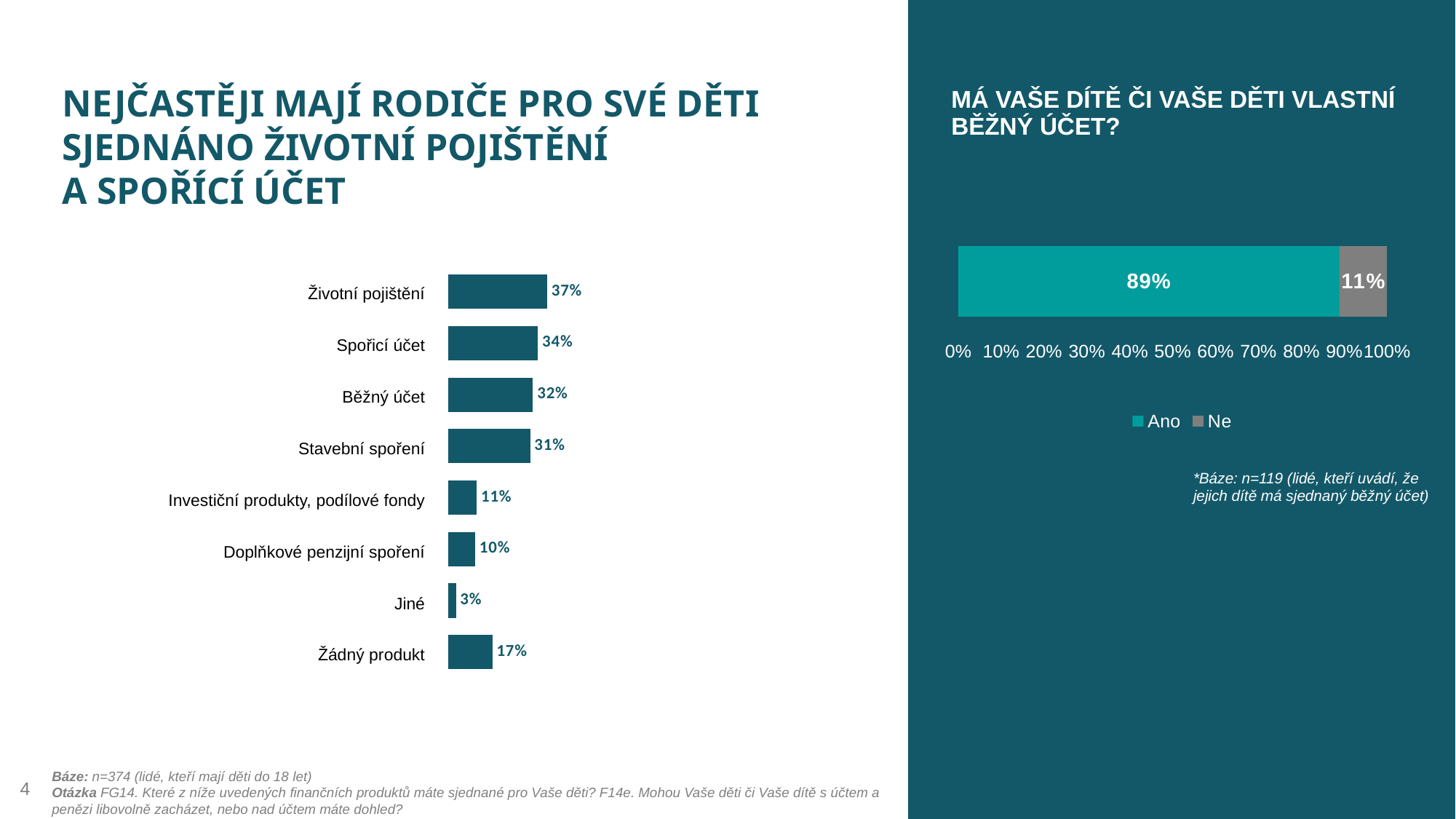
In the left bar chart, what is the value for Stavební spoření? 31% In the left bar chart, what is the difference between Spořicí účet and Běžný účet? 2% In the chart titled 'Má Vaše dítě či Vaše děti vlastní běžný účet?', what is the total of the stacked bar? 100% In the left bar chart, which category has the highest value? Životní pojištění How many series does the legend of the chart titled 'Má Vaše dítě či Vaše děti vlastní běžný účet?' list? 2 In the left bar chart, what is the value for Žádný produkt? 17% What kind of chart is the left chart? Bar chart In the chart titled 'Má Vaše dítě či Vaše děti vlastní běžný účet?', what is the value for Ano? 89% In the left bar chart, which category has the lowest value? Jiné In the left bar chart, what is the value for Životní pojištění? 37% How many categories does the left bar chart show? 8 In the left bar chart, which is larger: Investiční produkty, podílové fondy or Doplňkové penzijní spoření? Investiční produkty, podílové fondy